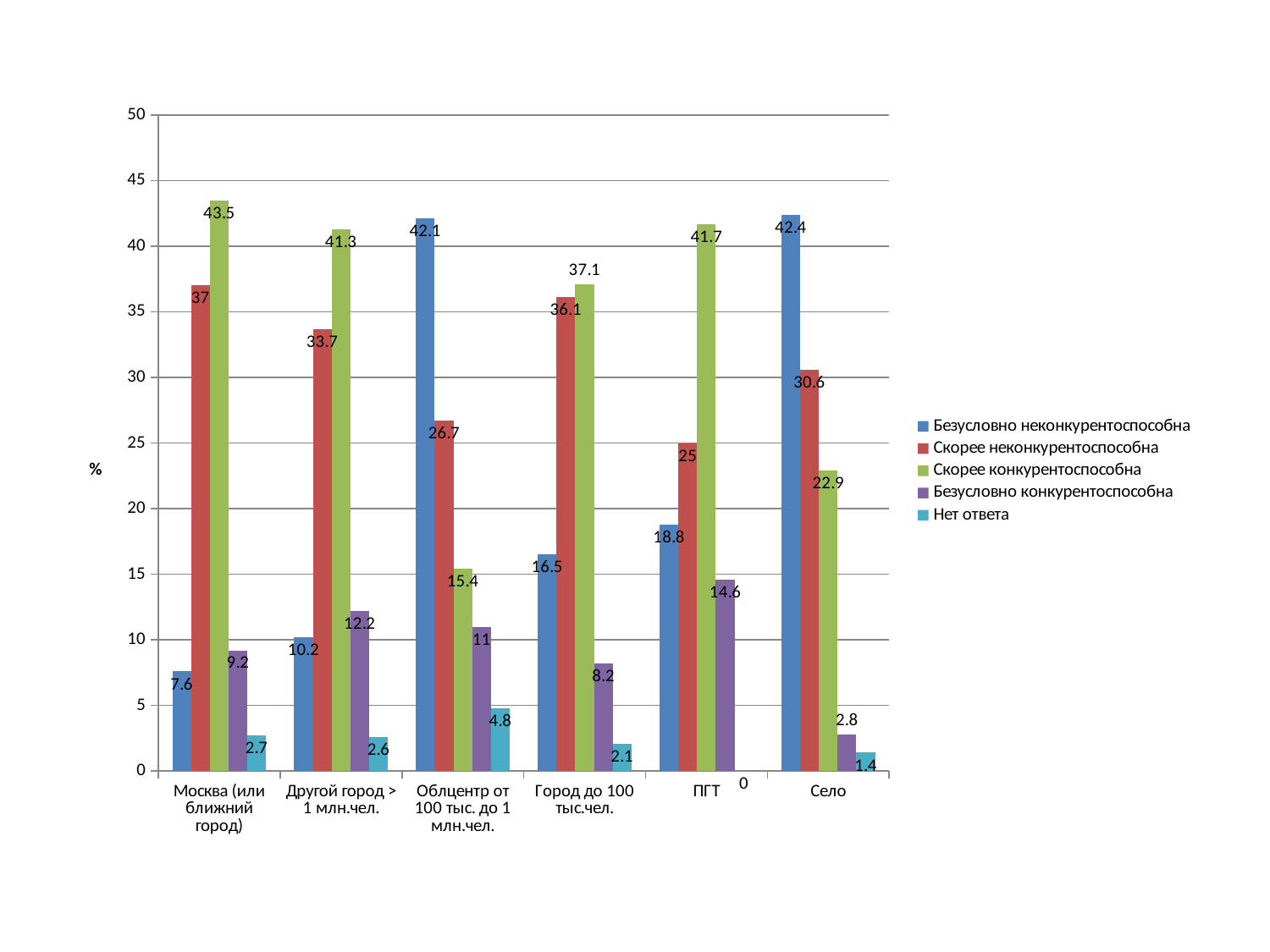
What is the value for "Скорее конкурентоспособна" in the Москва (или ближний город) category? 43.5 In the Город до 100 тыс.чел. category, which is larger: "Скорее конкурентоспособна" or "Скорее неконкурентоспособна"? Скорее конкурентоспособна What is the value for "Безусловно неконкурентоспособна" in the Село category? 42.4 Which category has the highest value for "Безусловно неконкурентоспособна"? Село What is the value for "Нет ответа" in the ПГТ category? 0 What kind of chart is shown on the slide? Bar chart How many categories are shown on the x axis? 6 What is the value for "Безусловно конкурентоспособна" in the Облцентр от 100 тыс. до 1 млн.чел. category? 11 How many series does the legend list? 5 Which category has the lowest value for "Скорее конкурентоспособна"? Облцентр от 100 тыс. до 1 млн.чел. What is the label on the vertical axis? % What is the difference between "Скорее неконкурентоспособна" and "Безусловно неконкурентоспособна" in the Другой город > 1 млн.чел. category? 23.5